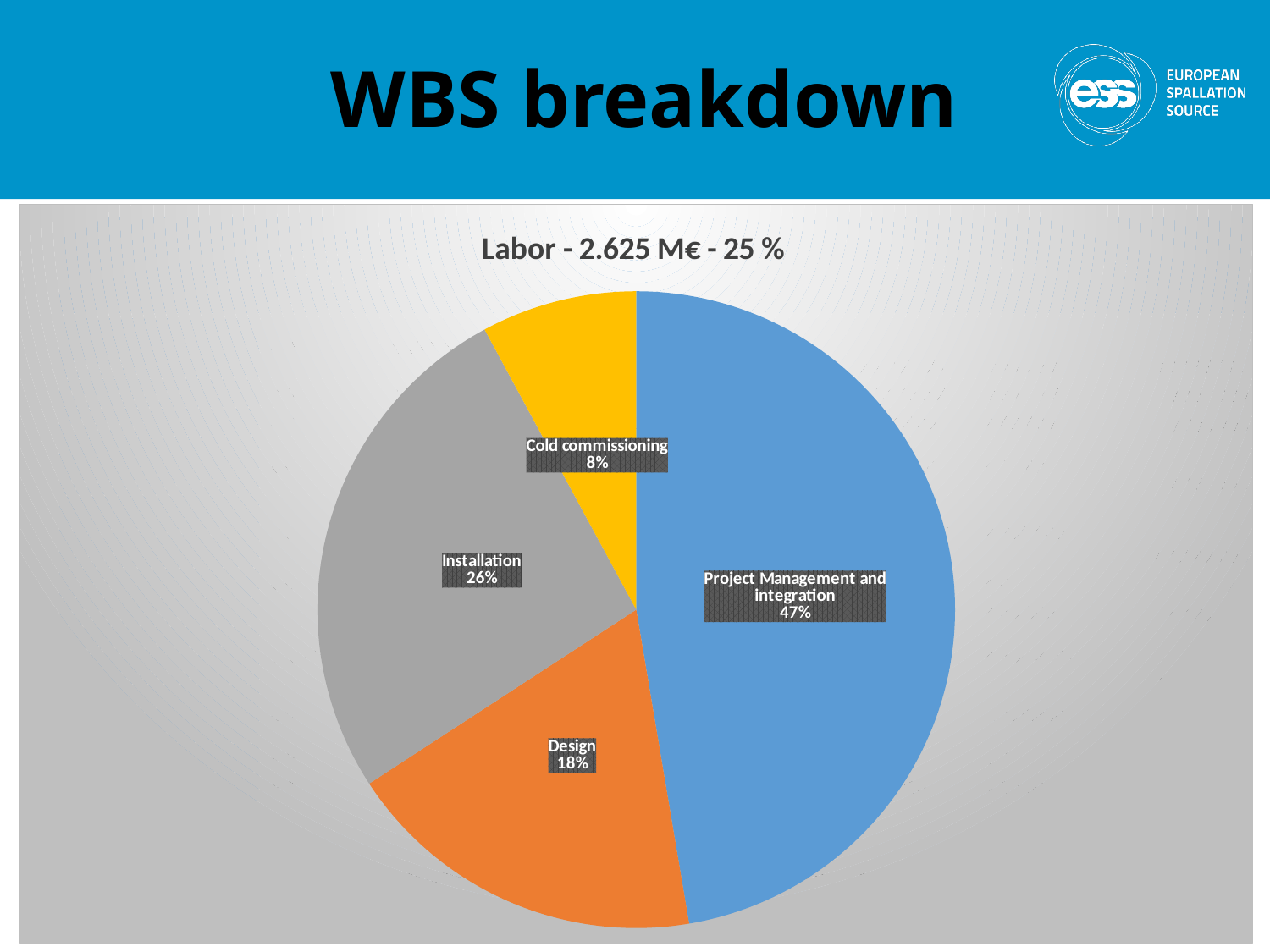
Which category has the smallest slice of the pie? Cold commissioning What share of the pie does Installation have? 26% What share of the pie does Cold commissioning have? 8% Which is larger, the share for Installation or the share for Cold commissioning? Installation Which category has the largest slice of the pie? Project Management and integration What share of the pie does Design have? 18% What is the difference in percentage points between Installation and Design? 8 How many slices does the pie chart have? 4 What kind of chart is shown on the slide? pie chart What is the title of the chart? Labor - 2.625 M€ - 25 % What colour is the Design slice? orange